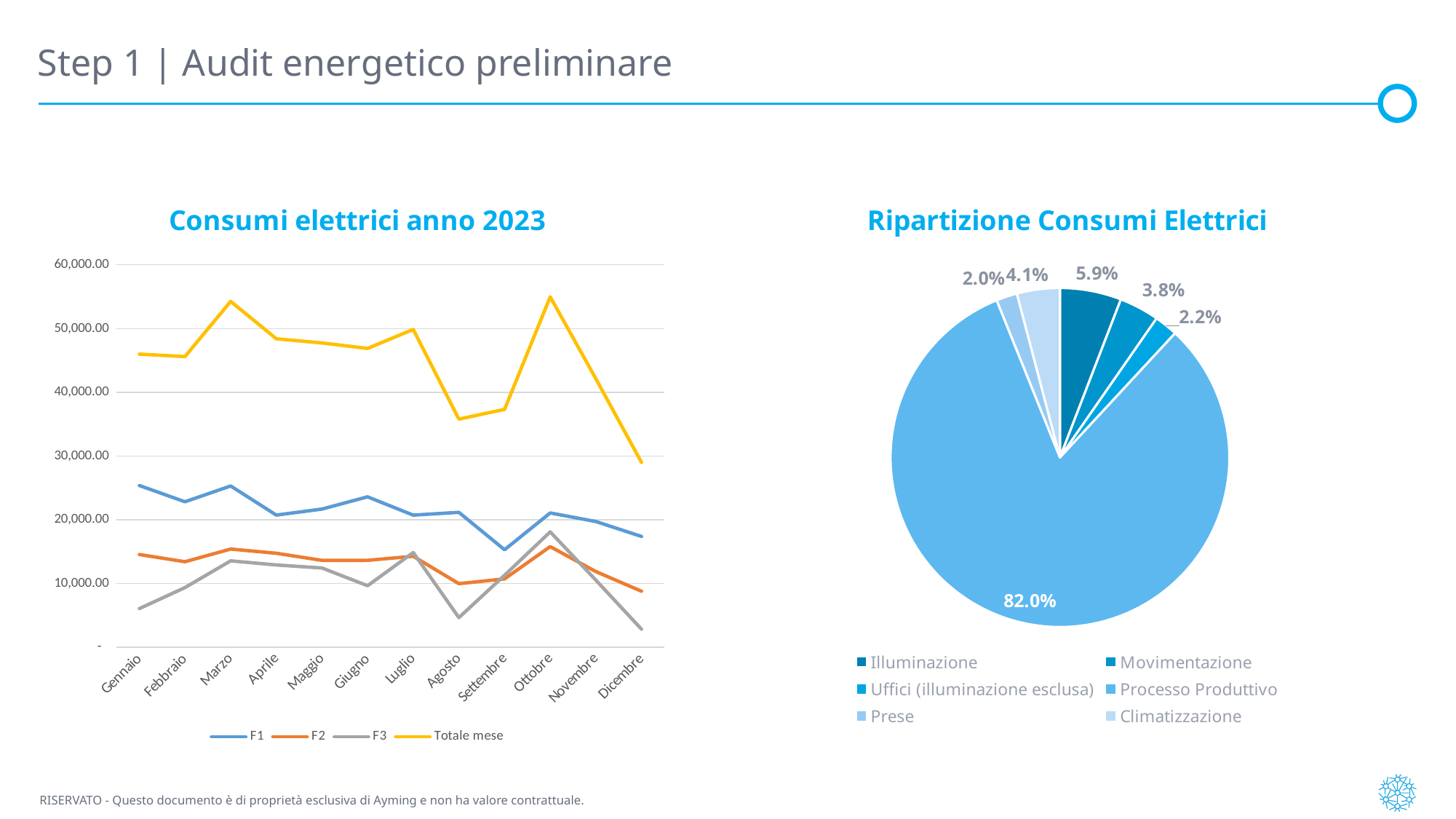
On the 'Ripartizione Consumi Elettrici' pie chart, what share does Processo Produttivo have? 82.0% What kind of chart is 'Consumi elettrici anno 2023'? Line chart On the 'Consumi elettrici anno 2023' chart, in which month is the Totale mese value lowest? Dicembre On the 'Consumi elettrici anno 2023' chart, is the Totale mese value for Ottobre greater or less than 50,000.00? greater How many categories does the legend of the 'Ripartizione Consumi Elettrici' pie chart list? 6 On the 'Ripartizione Consumi Elettrici' pie chart, which category has the smallest share? Prese How many series does the legend of the 'Consumi elettrici anno 2023' chart list? 4 On the 'Ripartizione Consumi Elettrici' pie chart, what share does Climatizzazione have? 4.1% On the 'Ripartizione Consumi Elettrici' pie chart, what share does Illuminazione have? 5.9% On the 'Ripartizione Consumi Elettrici' pie chart, what is the difference between the Movimentazione share and the Uffici (illuminazione esclusa) share? 1.6% On the 'Consumi elettrici anno 2023' chart, which series is higher in Gennaio, F1 or F2? F1 On the 'Ripartizione Consumi Elettrici' pie chart, which category has the largest share? Processo Produttivo